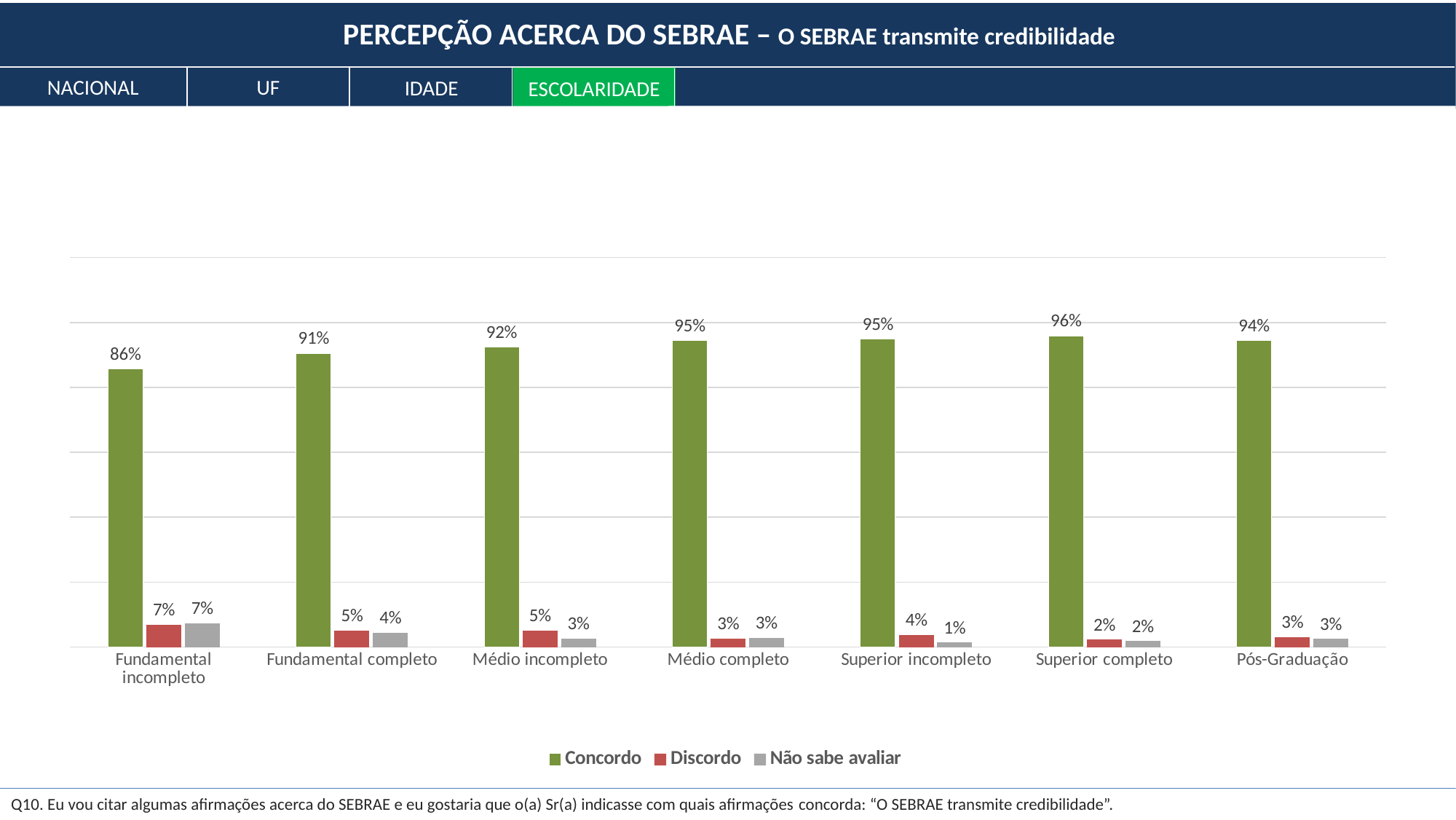
Which is larger, the Discordo value for Fundamental completo or for Superior completo? Fundamental completo What is the Concordo value for Fundamental incompleto? 86% What is the Não sabe avaliar value for Superior incompleto? 1% What is the Discordo value for Médio incompleto? 5% How many education categories are shown on the x axis? 7 What is the Concordo value for Pós-Graduação? 94% Which category has the highest Concordo value? Superior completo How many series does the legend list? 3 What kind of chart is shown on the slide? Bar chart Which tab is highlighted in green below the title? ESCOLARIDADE What is the difference between the Concordo values for Superior completo and Fundamental incompleto? 10% Which category has the lowest Concordo value? Fundamental incompleto